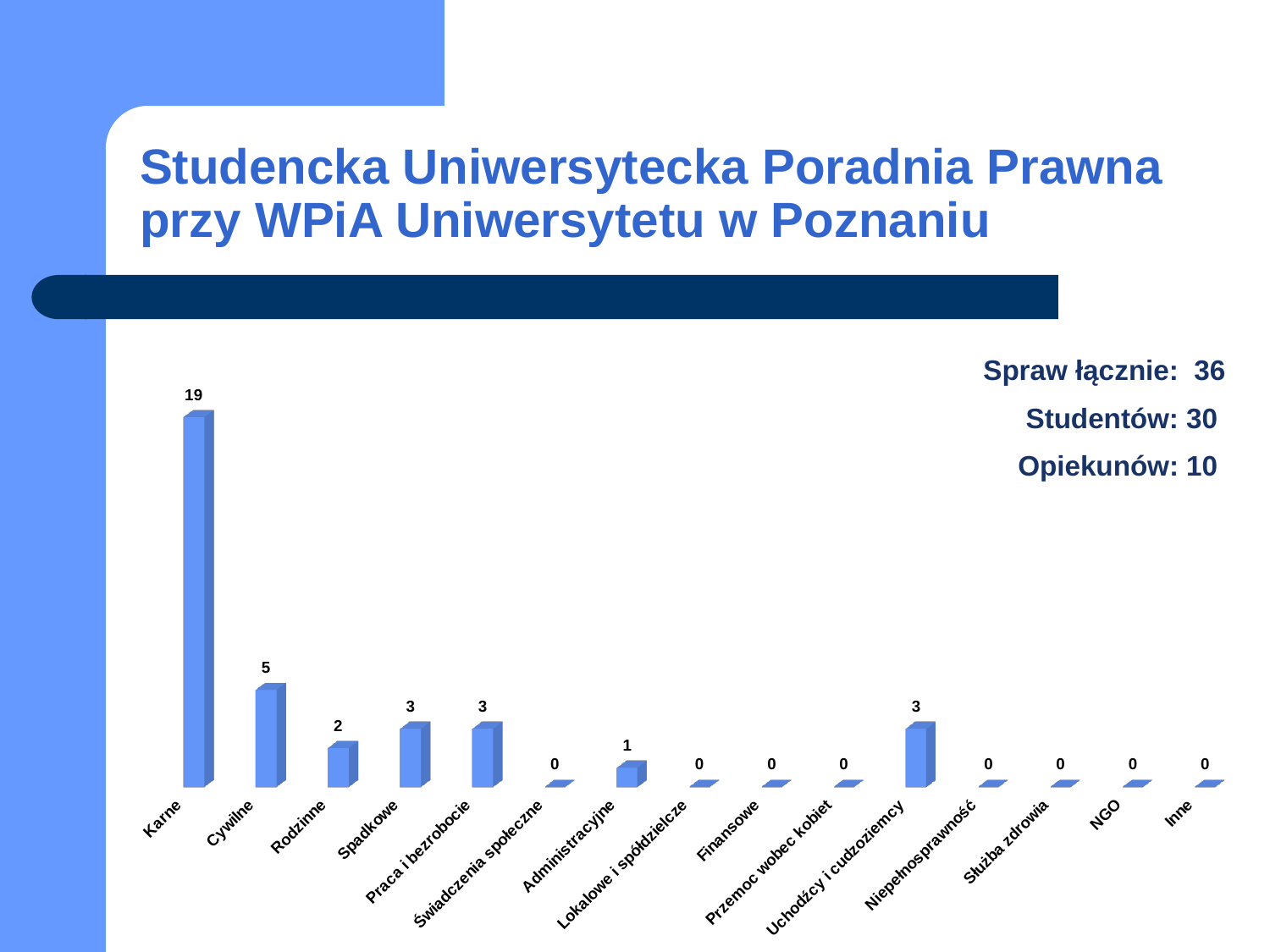
Which category has the highest value? Karne How many categories have a value of 0? 8 What is the value for Karne? 19 What is the value for Administracyjne? 1 What is the difference between the values for Karne and Cywilne? 14 What kind of chart is shown on the slide? Bar chart What is the value for Rodzinne? 2 What is the value for Uchodźcy i cudzoziemcy? 3 What is the value for Cywilne? 5 How many categories are shown on the x axis? 15 Which is larger, the value for Cywilne or the value for Praca i bezrobocie? Cywilne What is the difference between the values for Spadkowe and Rodzinne? 1